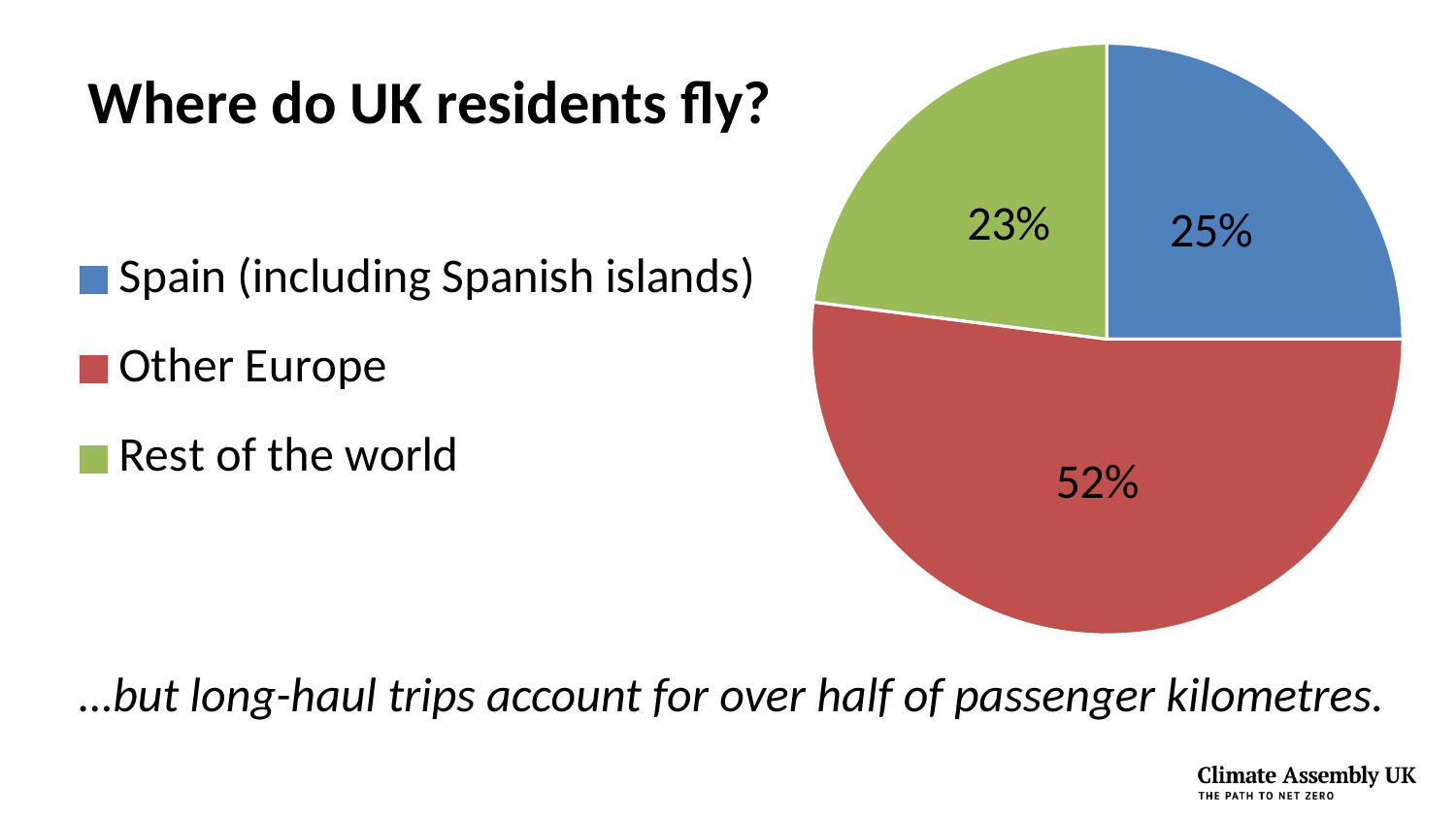
How many categories does the pie chart show? 3 What is the title of the chart? Where do UK residents fly? What share of the pie does Rest of the world account for? 23% What share of the pie does Other Europe account for? 52% Which category has the largest slice of the pie? Other Europe What is the difference in percentage points between Spain (including Spanish islands) and Rest of the world? 2 What is the difference in percentage points between Other Europe and Spain (including Spanish islands)? 27 What kind of chart is shown on the slide? pie chart What share of the pie does Spain (including Spanish islands) account for? 25% Which colour represents Rest of the world in the pie chart? green Which category has the smallest slice of the pie? Rest of the world Which is larger, the share for Other Europe or the share for Rest of the world? Other Europe